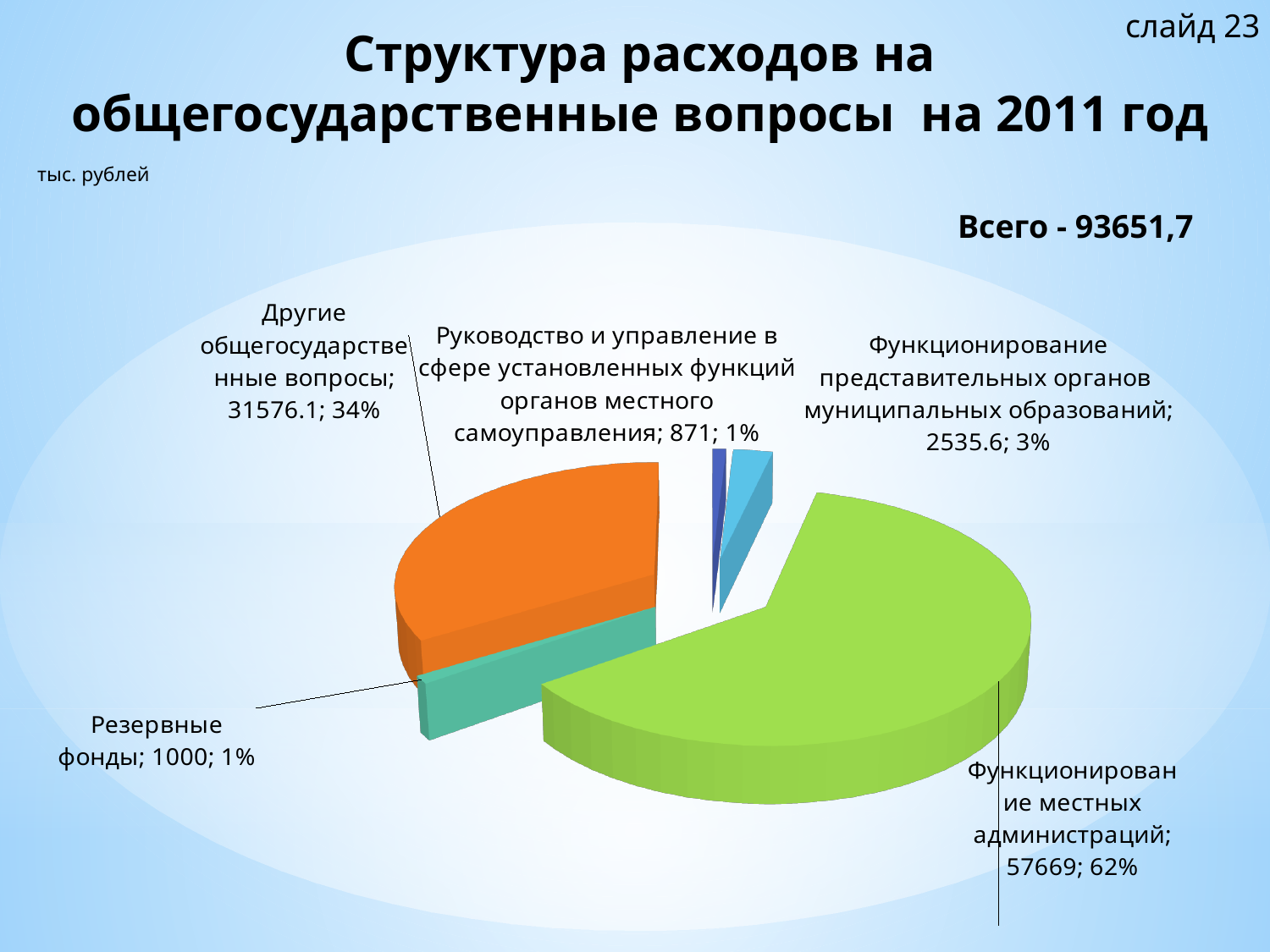
What is the value for Функционирование представительных органов муниципальных образований? 2535.6 Which category has the largest slice of the pie? Функционирование местных администраций What share of the pie does Функционирование местных администраций take? 62% What share of the pie does Другие общегосударственные вопросы take? 34% What kind of chart is shown on the slide? Pie chart Which category has the smallest value in the pie chart? Руководство и управление в сфере установленных функций органов местного самоуправления How many slices does the pie chart have? 5 What is the value for Резервные фонды? 1000 What is the value for Функционирование местных администраций? 57669 What is the value for Другие общегосударственные вопросы? 31576.1 What is the difference between the values for Функционирование местных администраций and Другие общегосударственные вопросы? 26092.9 What total is stated on the slide for the expenditures? 93651,7